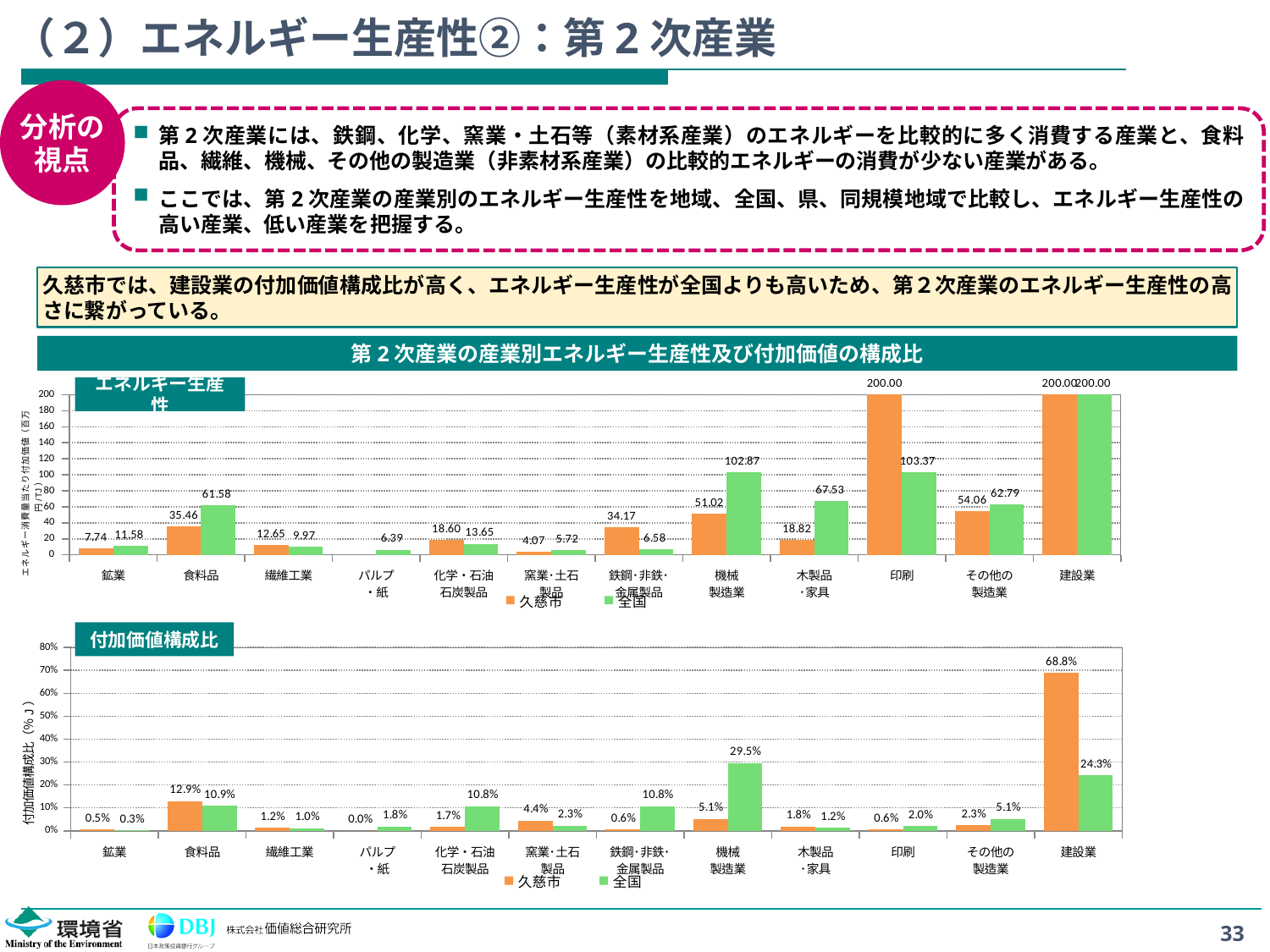
In the 付加価値構成比 chart (bottom), how many industry categories are shown on the x axis? 12 In the エネルギー生産性 chart (top), which is larger for 鉄鋼・非鉄・金属製品, 久慈市 or 全国? 久慈市 In the 付加価値構成比 chart (bottom), what is the value for 久慈市 in 建設業? 68.8% What type of chart is the 付加価値構成比 chart (bottom)? Bar chart In the 付加価値構成比 chart (bottom), which colour represents 全国? Green In the 付加価値構成比 chart (bottom), what is the difference between the 久慈市 and 全国 values for 建設業? 44.5% In the 付加価値構成比 chart (bottom), which category has the highest 全国 value? 機械製造業 In the エネルギー生産性 chart (top), what is the value for 久慈市 in 機械製造業? 51.02 In the エネルギー生産性 chart (top), what is the value for 全国 in 木製品・家具? 67.53 In the エネルギー生産性 chart (top), what is the difference between the 全国 and 久慈市 values for 食料品? 26.12 In the エネルギー生産性 chart (top), how many series does the legend list? 2 In the エネルギー生産性 chart (top), which category has the lowest 久慈市 value among those with a printed label? 窯業・土石製品